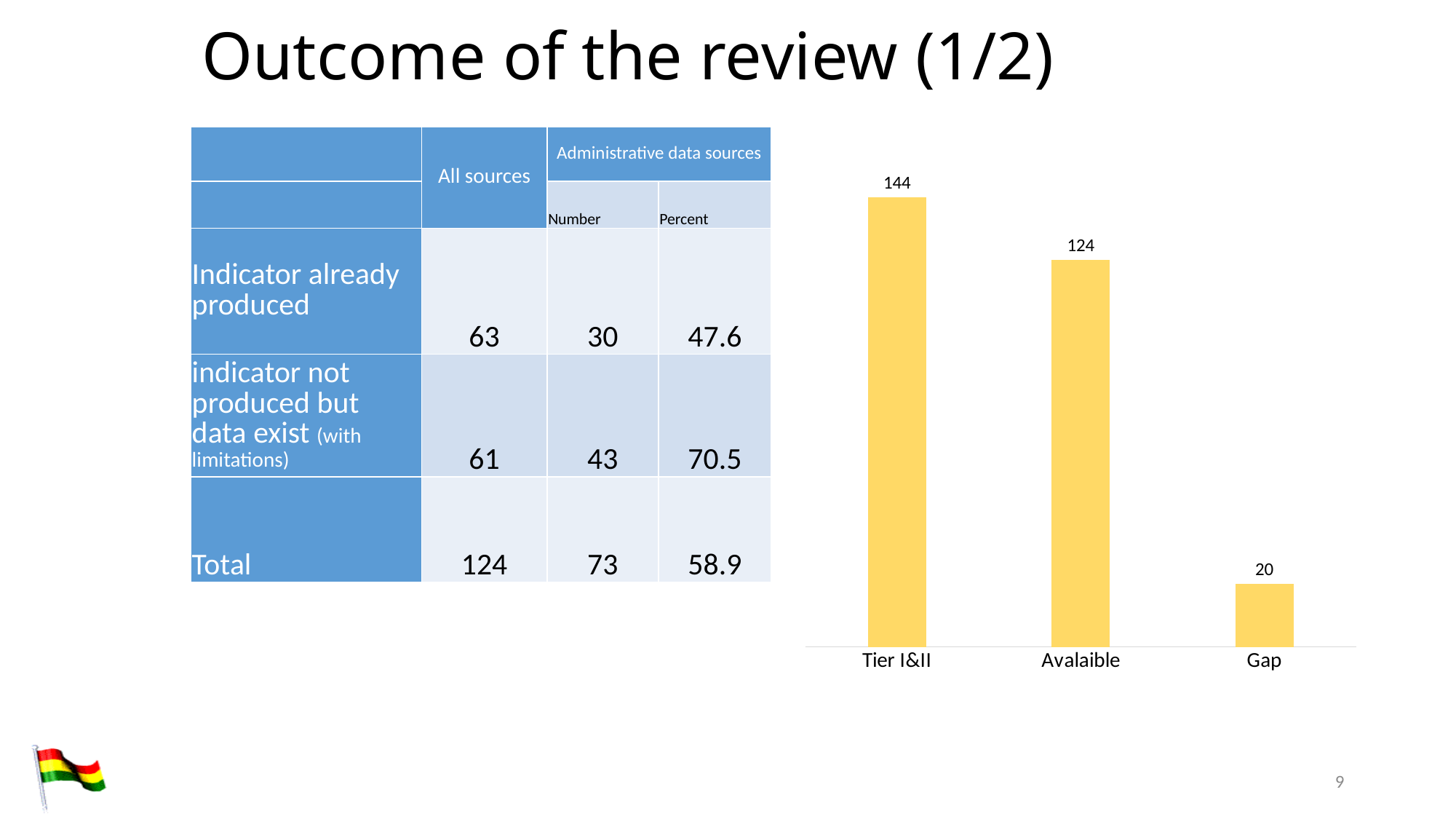
Which category has the highest bar in the chart? Tier I&II What is the difference between the Avalaible bar and the Gap bar? 104 Which category has the lowest bar in the chart? Gap Which is larger, the bar for Tier I&II or the bar for Avalaible? Tier I&II What is the value of the bar for Tier I&II? 144 What type of chart is shown on the slide? bar chart What is the value of the bar for Avalaible? 124 What is the difference between the Tier I&II bar and the Avalaible bar? 20 Do the bar values rise or fall from left to right across the chart? fall What is the value of the bar for Gap? 20 How many bars are shown in the chart? 3 What colour are the bars in the chart? yellow